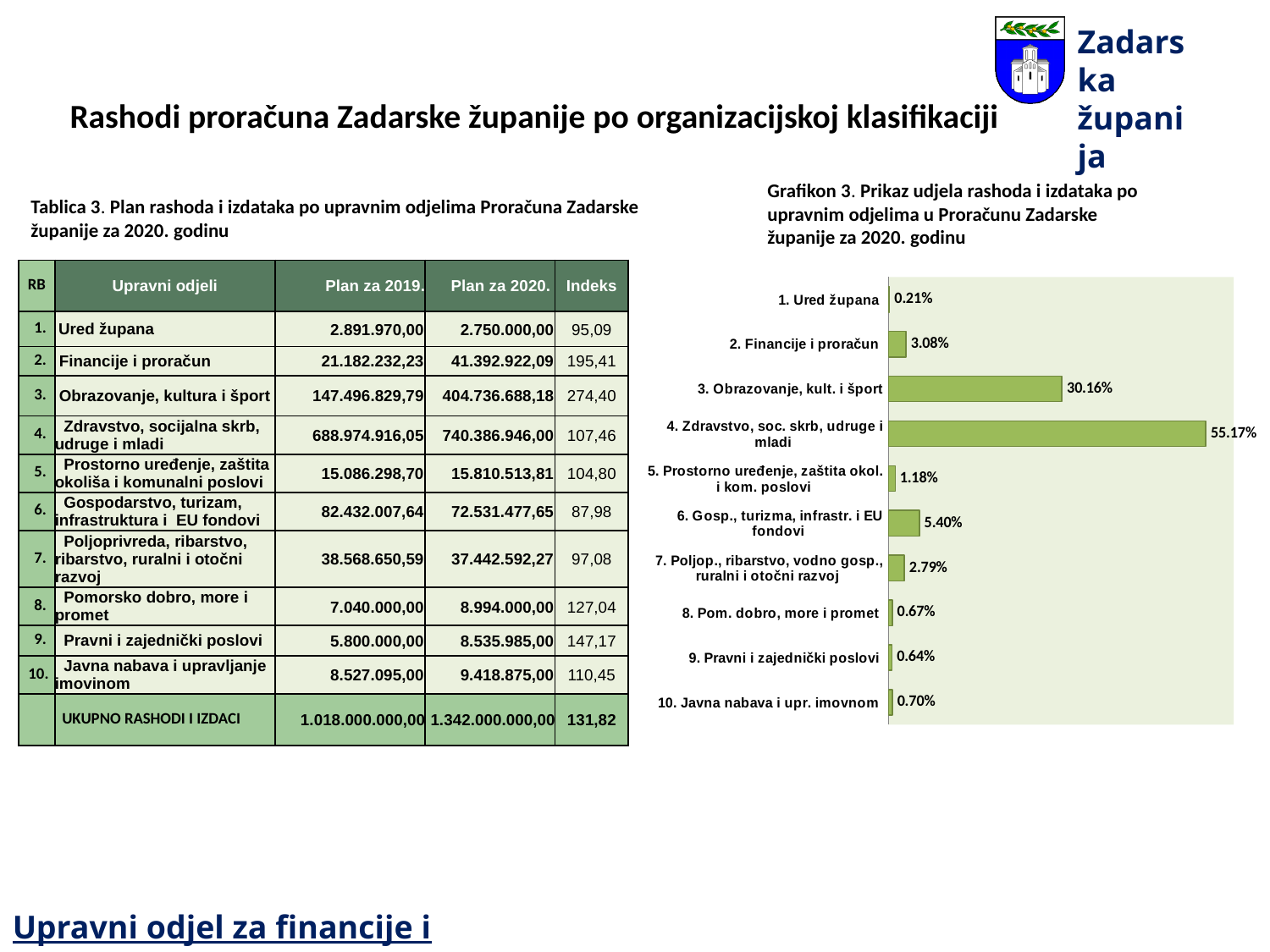
What is the title of the chart on the slide? Grafikon 3. Prikaz udjela rashoda i izdataka po upravnim odjelima u Proračunu Zadarske županije za 2020. godinu Which category has the lowest value in the chart? 1. Ured župana What is the value shown for '3. Obrazovanje, kult. i šport' in the chart? 30.16% What is the difference between the values for '4. Zdravstvo, soc. skrb, udruge i mladi' and '3. Obrazovanje, kult. i šport'? 25.01% What is the value shown for '4. Zdravstvo, soc. skrb, udruge i mladi' in the chart? 55.17% What kind of chart is shown on the slide? Bar chart How many categories are shown in the chart? 10 What is the value shown for '2. Financije i proračun' in the chart? 3.08% Which category has the highest value in the chart? 4. Zdravstvo, soc. skrb, udruge i mladi What is the value shown for '6. Gosp., turizma, infrastr. i EU fondovi' in the chart? 5.40% Which is larger in the chart: the value for '6. Gosp., turizma, infrastr. i EU fondovi' or for '7. Poljop., ribarstvo, vodno gosp., ruralni i otočni razvoj'? 6. Gosp., turizma, infrastr. i EU fondovi What is the value shown for '10. Javna nabava i upr. imovnom' in the chart? 0.70%